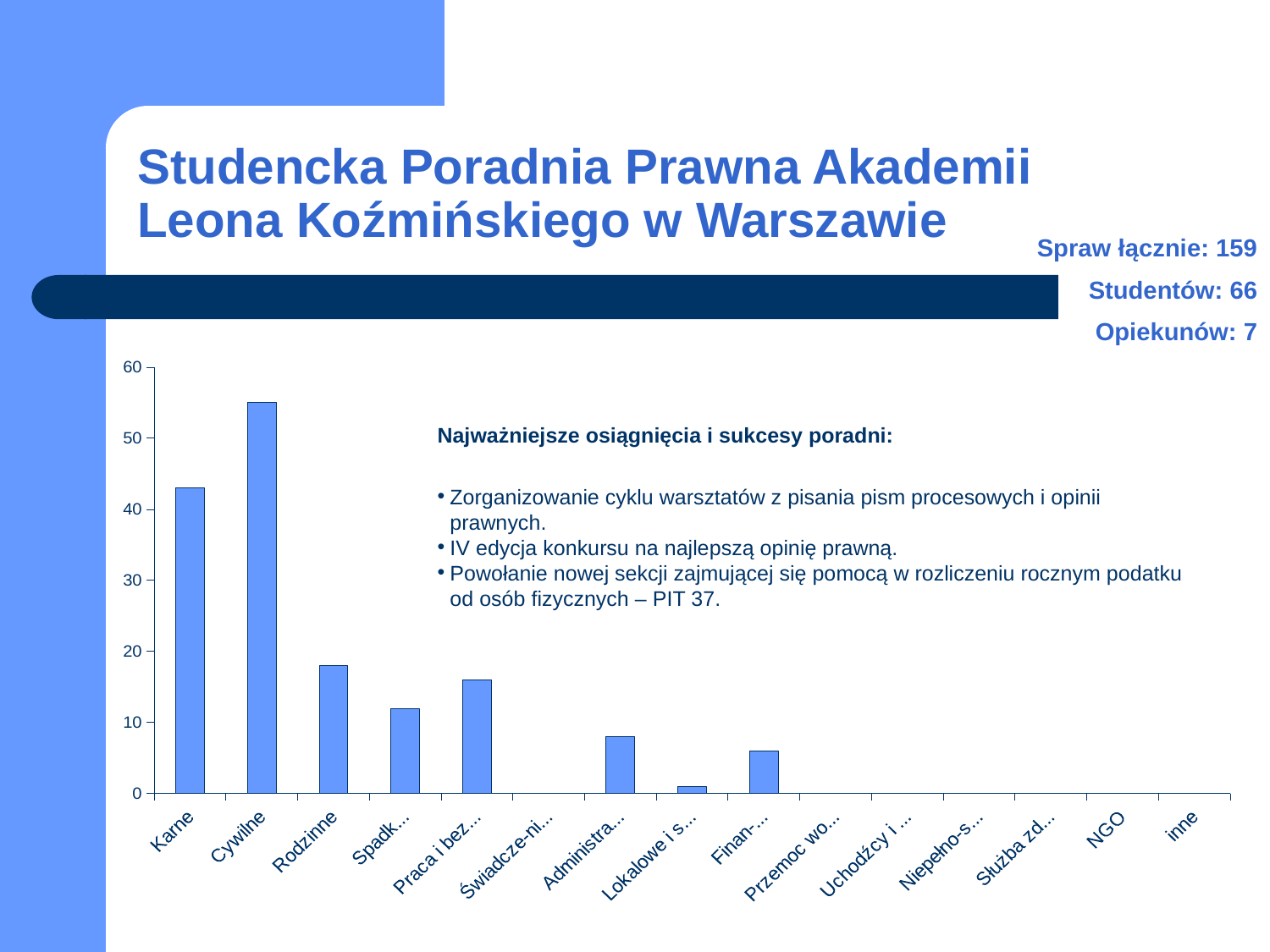
Is the value for Cywilne greater or less than 50? greater What kind of chart is shown on the slide? bar chart Is the value for Rodzinne greater or less than 20? less What is the highest value shown on the vertical axis of the chart? 60 Is the value for Administra... greater or less than 10? less Which is larger, the value for Rodzinne or the value for Spadk...? Rodzinne Which is larger, the value for Karne or the value for Cywilne? Cywilne How many categories are shown on the x axis of the bar chart? 15 Which category has the highest bar in the chart? Cywilne